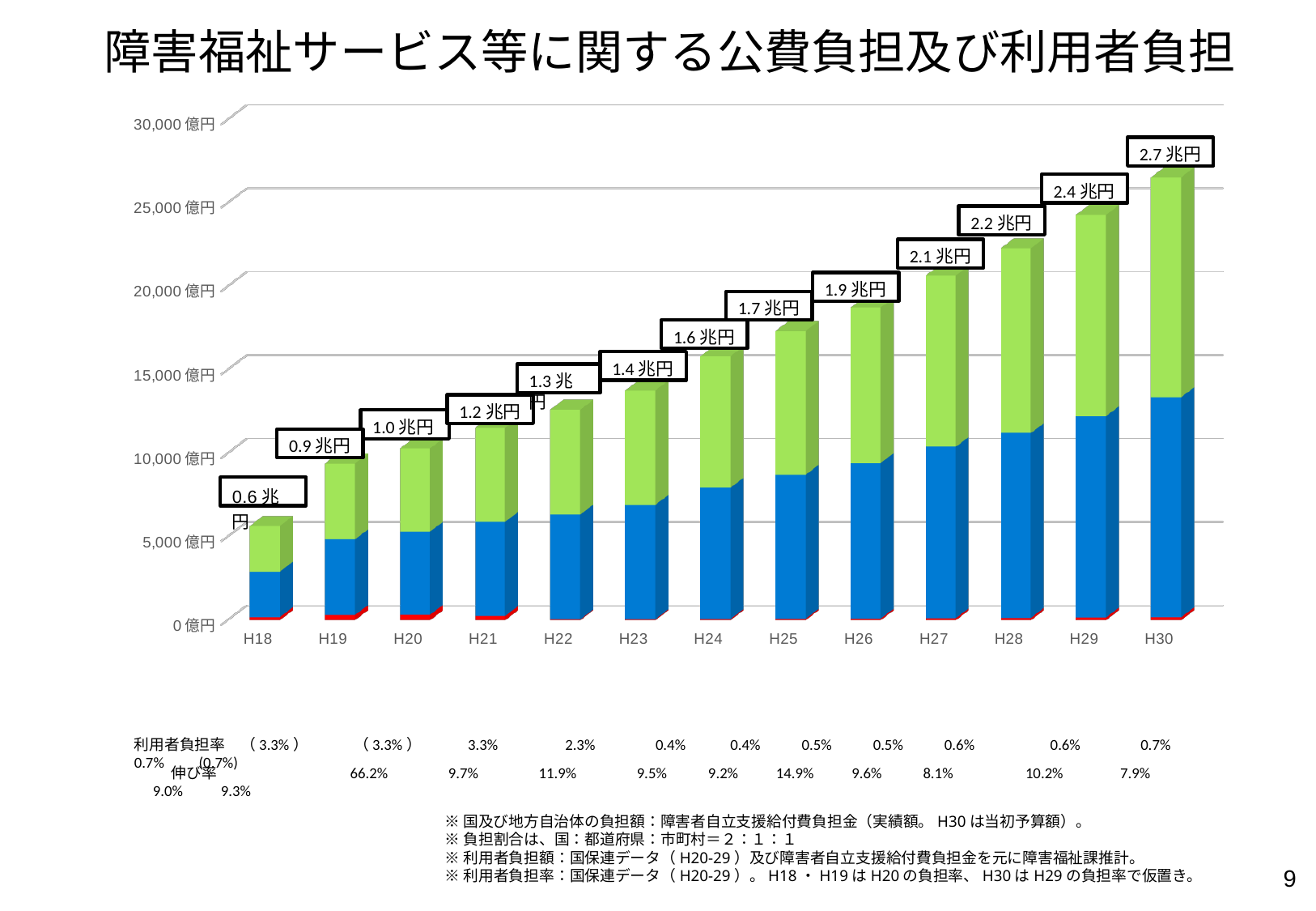
What total value is labelled for H21? 1.2兆円 What is the difference between the labelled totals for H30 and H18? 2.1兆円 What kind of chart is shown? Stacked bar chart What total value is labelled for H30? 2.7兆円 Which year has the highest total? H30 Is the total for H27 greater or less than 20,000億円? greater What total value is labelled for H25? 1.7兆円 Which year has the lowest total? H18 Which has the larger total, H26 or H23? H26 What total value is labelled for H18? 0.6兆円 Do the totals rise or fall from H18 to H30? Rise How many years are shown on the x axis? 13